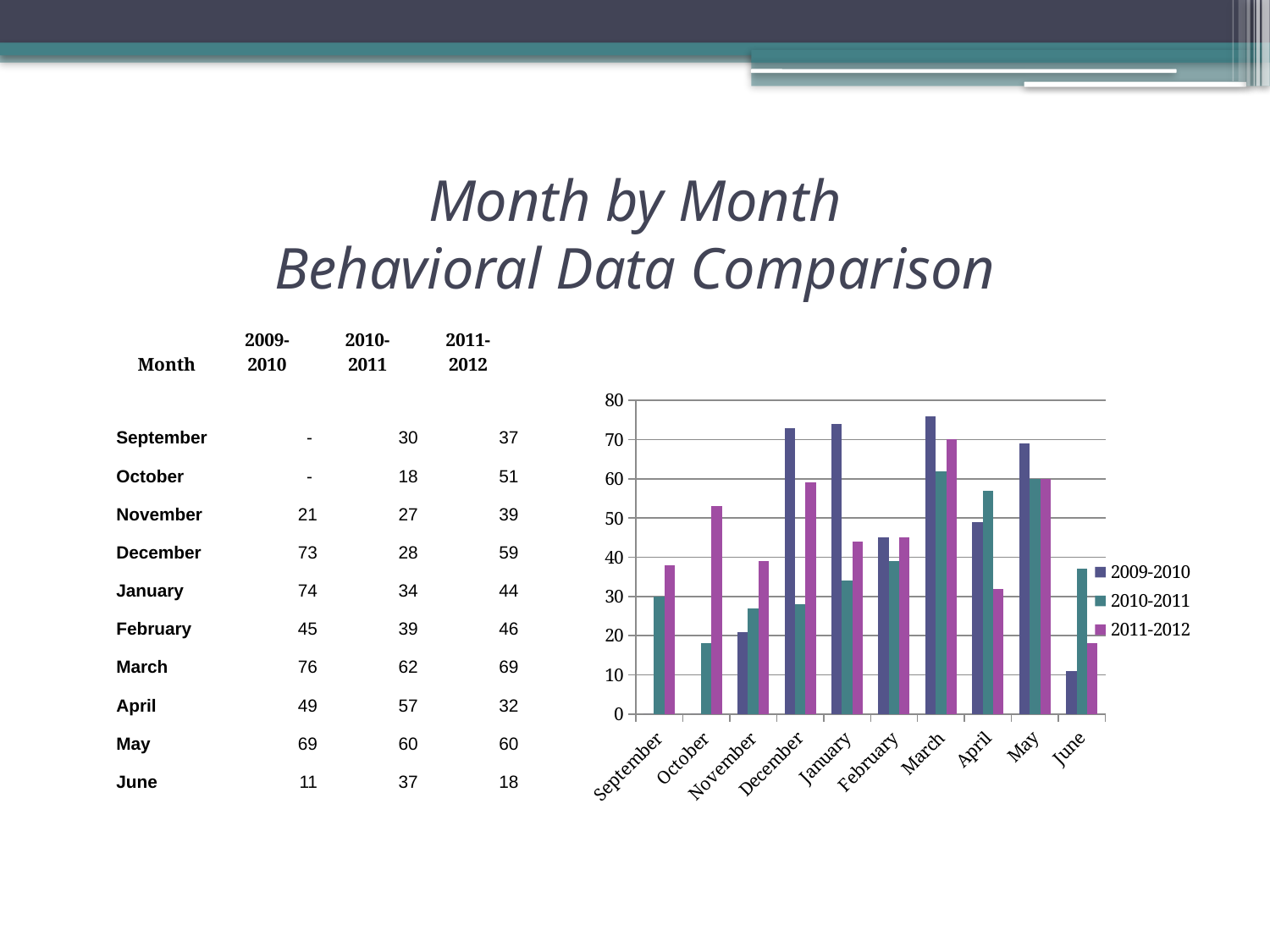
How many months are shown on the x axis of the chart? 10 Which month has the highest value in the 2010-2011 series? March Is the value for January in the 2009-2010 series greater or less than 70? greater Which month has the lowest value in the 2011-2012 series? June Which series is shown in magenta in the chart? 2011-2012 What kind of chart is shown on the slide? bar chart Which is larger for April: the 2010-2011 value or the 2011-2012 value? 2010-2011 How many series does the chart legend list? 3 What is the difference between the 2009-2010 and 2010-2011 values for December? 45 What is the value for March in the 2009-2010 series? 76 What is the value for October in the 2011-2012 series? 51